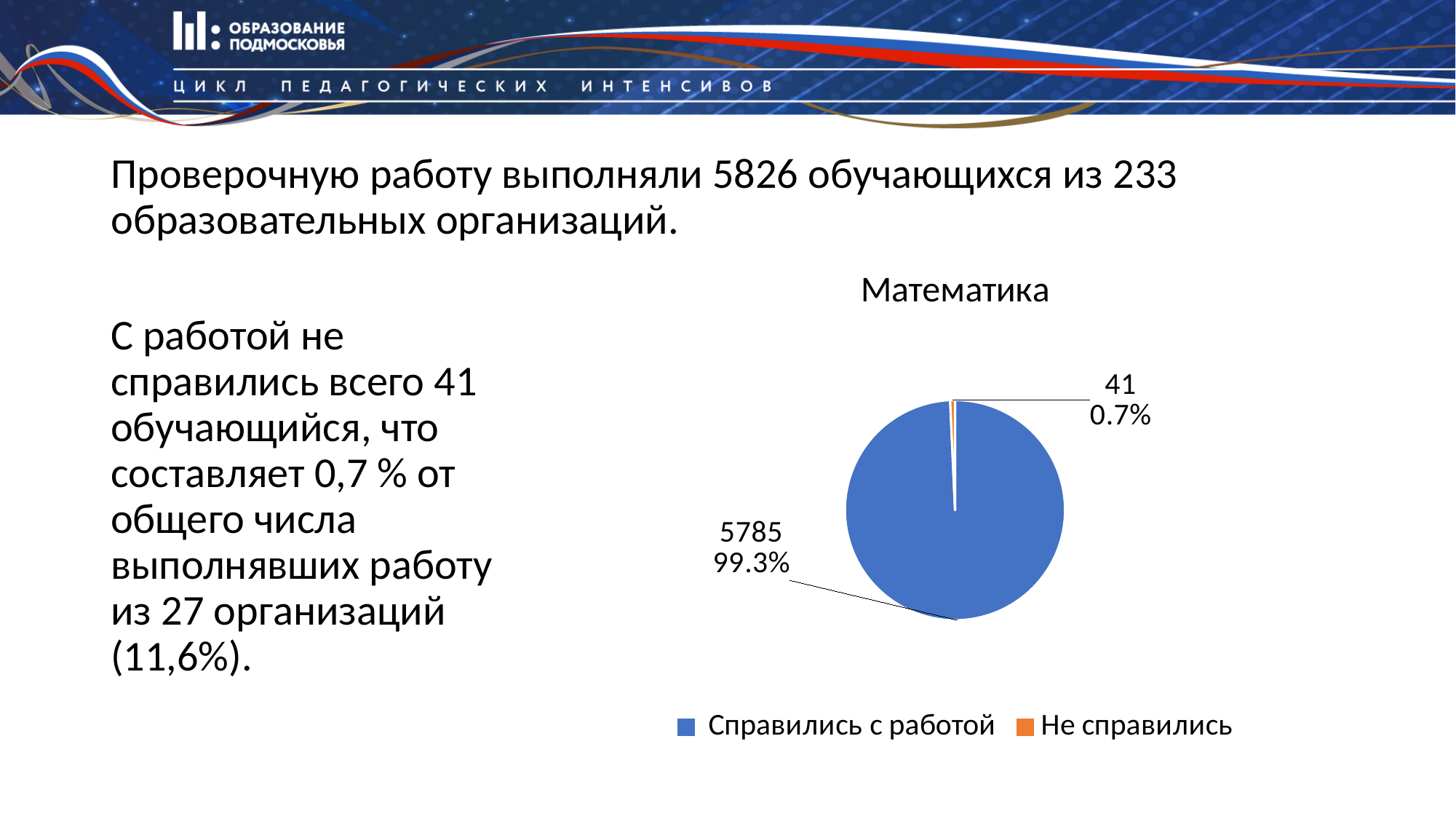
What is the difference between the values for 'Справились с работой' and 'Не справились'? 5744 What share of the pie does 'Справились с работой' represent? 99.3% Which category has the largest slice? Справились с работой What is the value for 'Справились с работой'? 5785 What is the value for 'Не справились'? 41 What type of chart is shown on the slide? pie chart How many slices does the pie chart have? 2 What share of the pie does 'Не справились' represent? 0.7% What is the title of the chart? Математика Which colour represents 'Не справились' in the chart? orange Which category has the smallest slice? Не справились How many entries does the chart legend list? 2